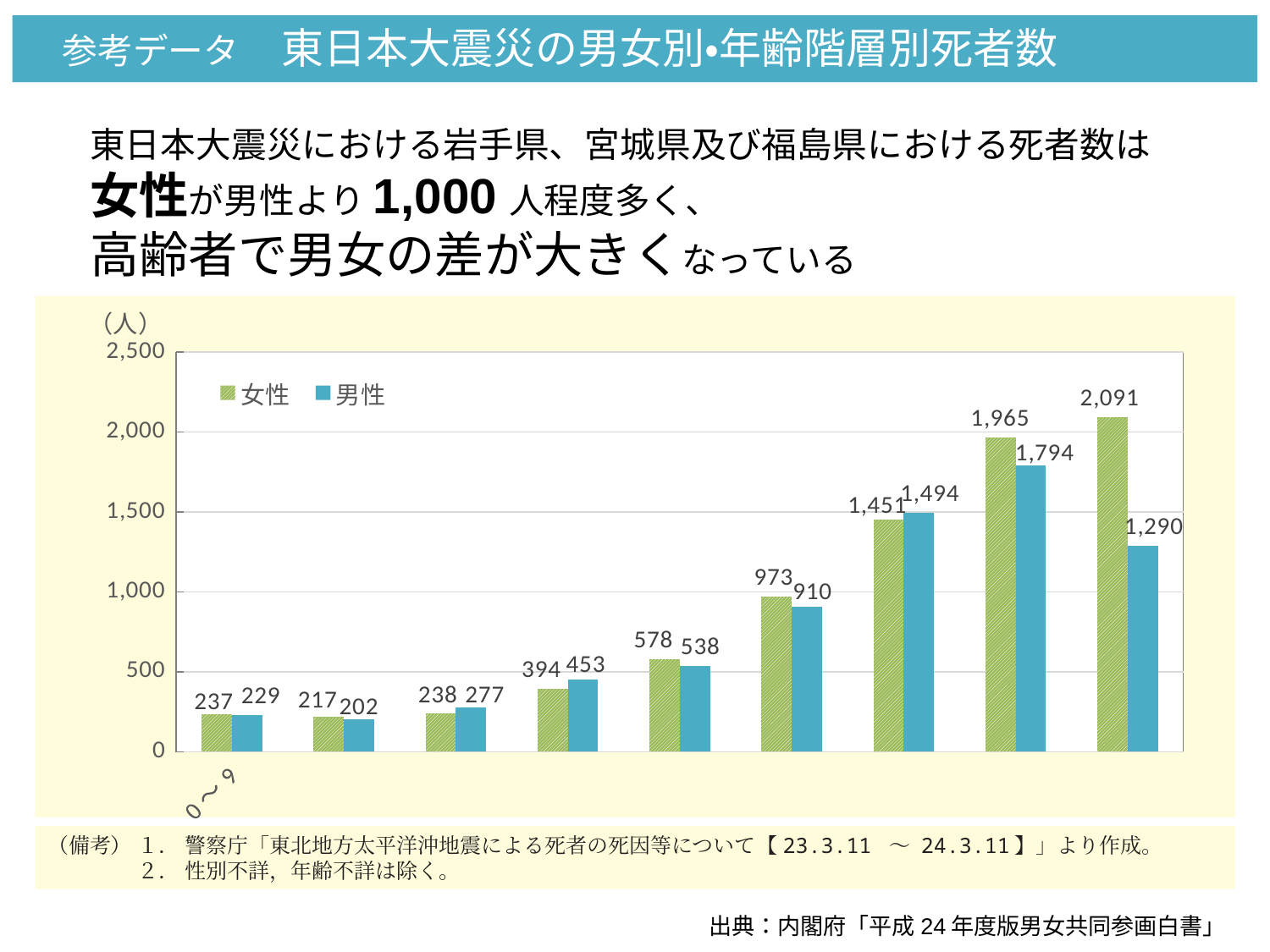
What kind of chart is shown on the slide? bar chart How many age groups (pairs of bars) are plotted in the chart? 9 In the 0～9 age group, which series has the larger value, 女性 or 男性? 女性 What is the value for 男性 in the 0～9 age group? 229 What is the highest value plotted for the 女性 series? 2,091 What is the highest value plotted for the 男性 series? 1,794 Which colour represents the 女性 series in the chart? green What is the lowest value plotted for the 男性 series? 202 What is the value for 女性 in the 0～9 age group? 237 How many series does the chart legend list? 2 In the rightmost age group, what is the difference between the 女性 value (2,091) and the 男性 value (1,290)? 801 Is the 男性 value in the rightmost age group greater or less than 1,500? less